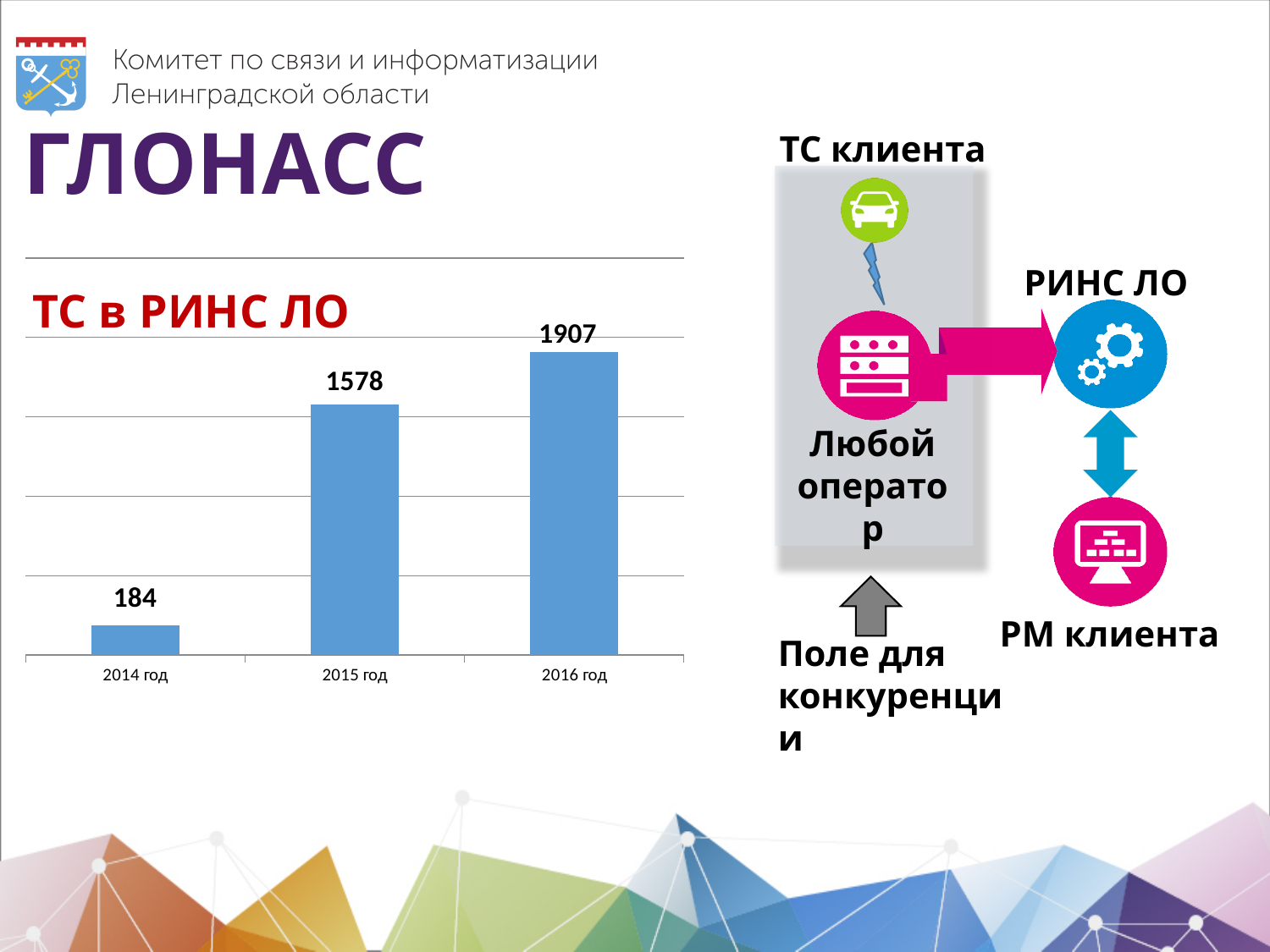
How many years are shown on the x axis of the chart? 3 What is the title of the chart? ТС в РИНС ЛО What kind of chart is shown on the slide? bar chart Which year has the highest value in the chart? 2016 год Which is larger, the value for 2015 год or the value for 2014 год? 2015 год Do the values rise or fall from 2014 год to 2016 год? rise What is the value for 2014 год in the chart? 184 What is the value for 2016 год in the chart? 1907 What is the value for 2015 год in the chart? 1578 What is the difference between the values for 2015 год and 2014 год? 1394 Which year has the lowest value in the chart? 2014 год What is the difference between the values for 2016 год and 2015 год? 329